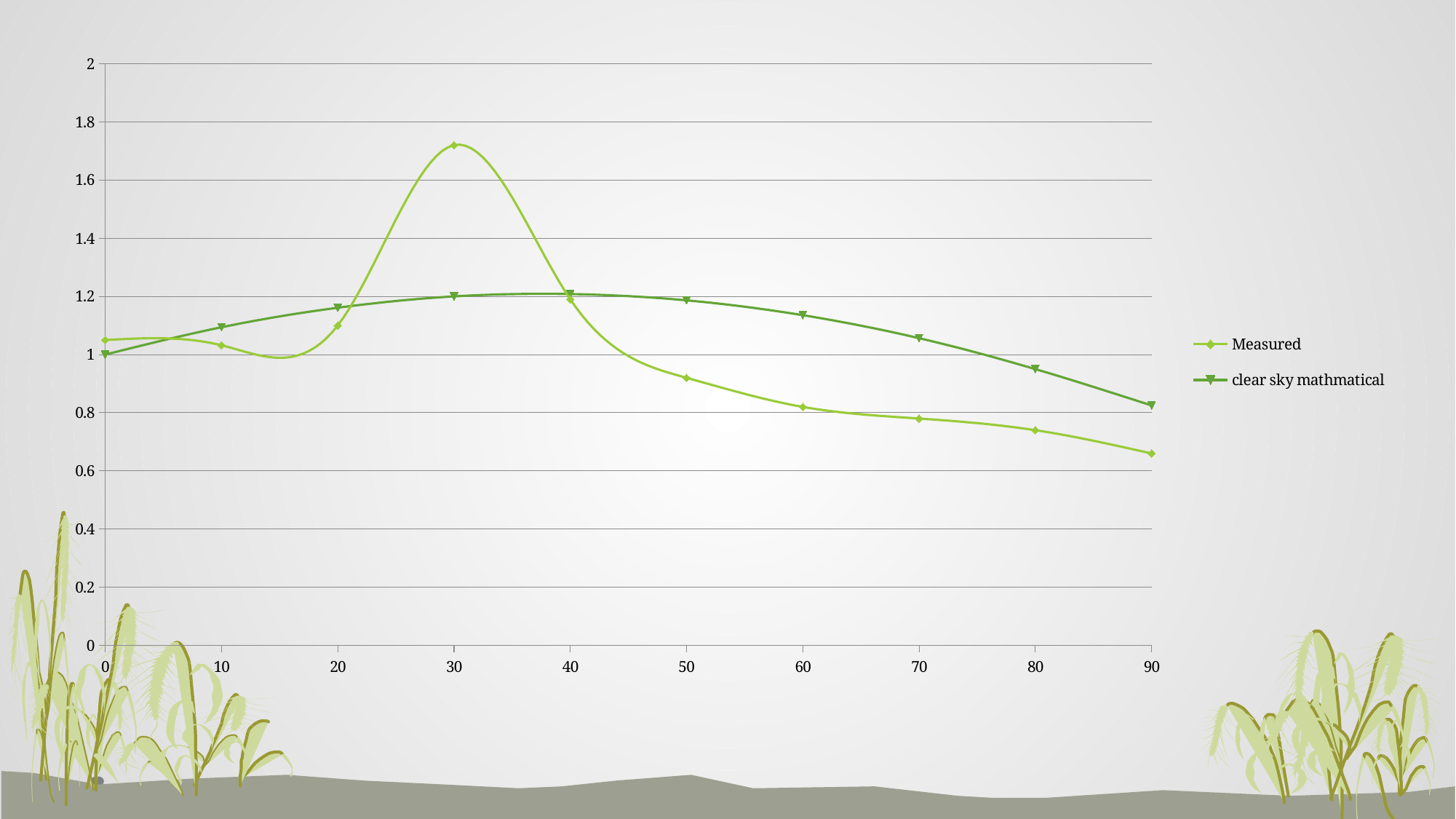
How many series does the legend list? 2 At x = 30, which series has the higher value, Measured or clear sky mathmatical? Measured Does the Measured series rise or fall from x = 40 to x = 90? fall What kind of chart is shown on the slide? line chart At which x value does the Measured series reach its lowest value? 90 Is the clear sky mathmatical value at x = 90 greater or less than 1? less Is the Measured value at x = 30 greater or less than 1.6? greater Is the Measured value at x = 90 greater or less than 0.8? less At which x value does the Measured series reach its highest value? 30 How many data points does the Measured series have? 10 At x = 60, which series has the higher value, Measured or clear sky mathmatical? clear sky mathmatical At which x value does the clear sky mathmatical series reach its lowest value? 90